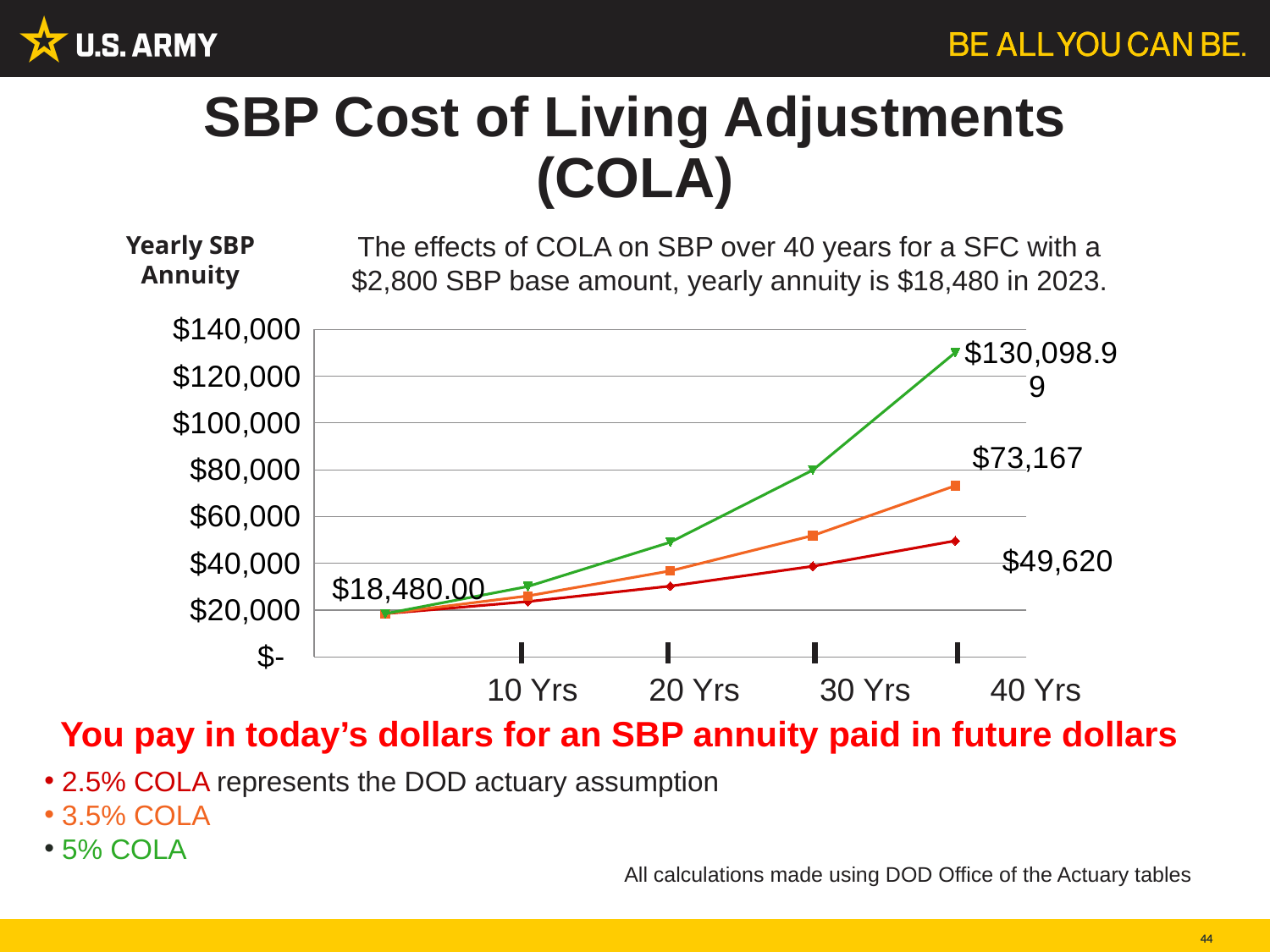
What is the yearly SBP annuity value at 40 years for the 5% COLA (green) line? $130,098.99 What is the yearly SBP annuity value at 40 years for the 3.5% COLA (orange) line? $73,167 What kind of chart is shown on the slide? line chart How many year labels are shown on the x axis of the chart? 4 What is the starting yearly SBP annuity value shown at the left of the chart? $18,480.00 Do the values on the chart rise or fall as the years increase along the x axis? rise At 40 years, is the value for the 3.5% COLA line larger or smaller than the value for the 5% COLA line? smaller What is the difference between the 40-year values of the 3.5% COLA line and the 2.5% COLA line? $23,547 Which COLA rate line has the lowest value at 40 years? 2.5% COLA What is the yearly SBP annuity value at 40 years for the 2.5% COLA (red) line? $49,620 Which COLA rate line reaches the highest value at 40 years? 5% COLA Is the value for the 5% COLA line at 30 years greater or less than $60,000? greater